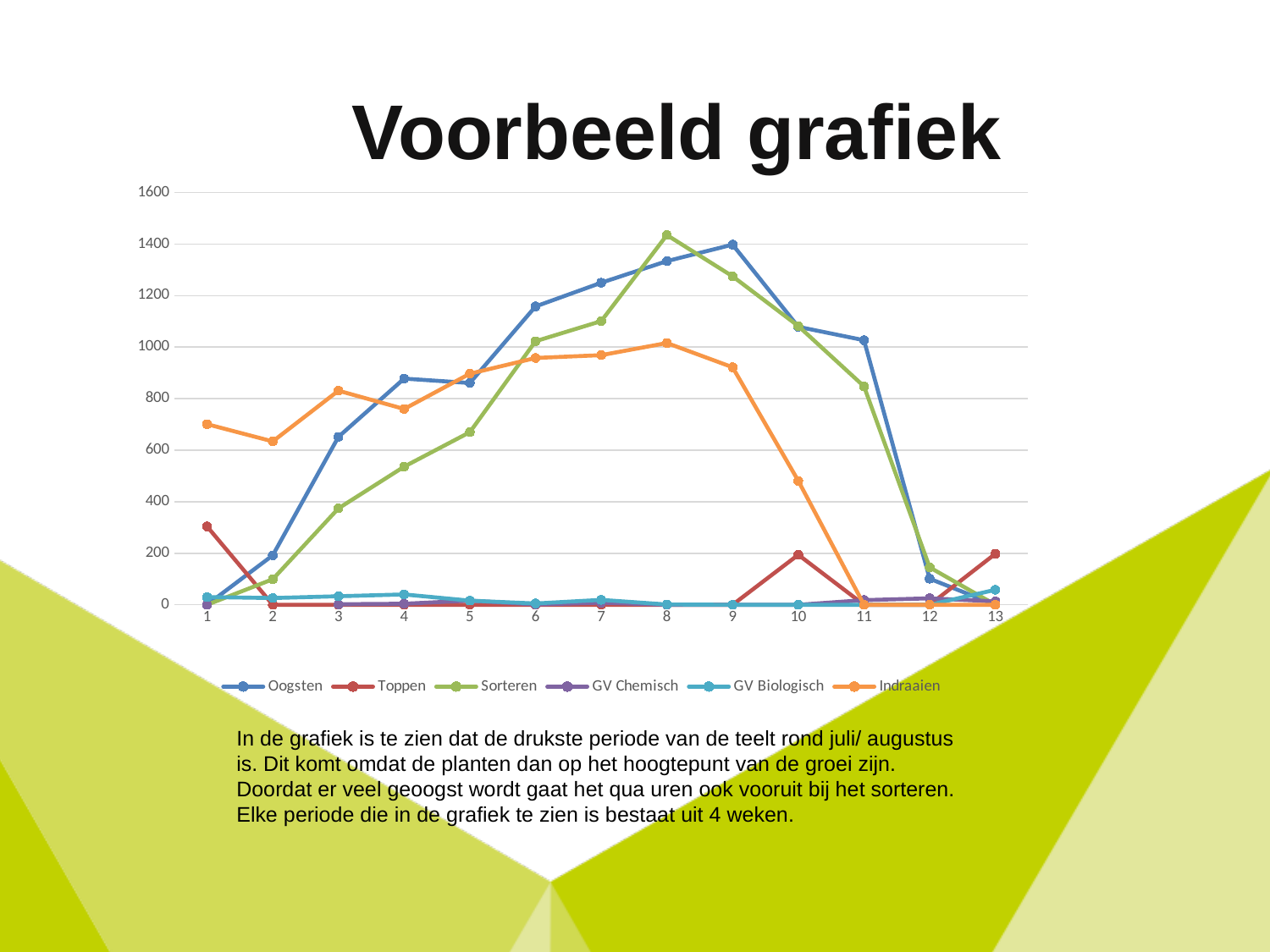
Is the value for Indraaien at point 10 greater or less than 600? less Is the value for Oogsten at point 8 greater or less than 1200? greater Which series is shown in orange in the legend? Indraaien Is the value for Toppen at point 1 greater or less than 200? greater How many series does the legend list? 6 How many points are plotted along the x axis? 13 At point 5, which is larger: Indraaien or Sorteren? Indraaien What kind of chart is shown on the slide? Line chart At which x-axis point does the Sorteren series reach its highest value? 8 Does the Oogsten series rise or fall from point 1 to point 9? Rise At which x-axis point does the Oogsten series reach its highest value? 9 What is the title of the slide containing the chart? Voorbeeld grafiek